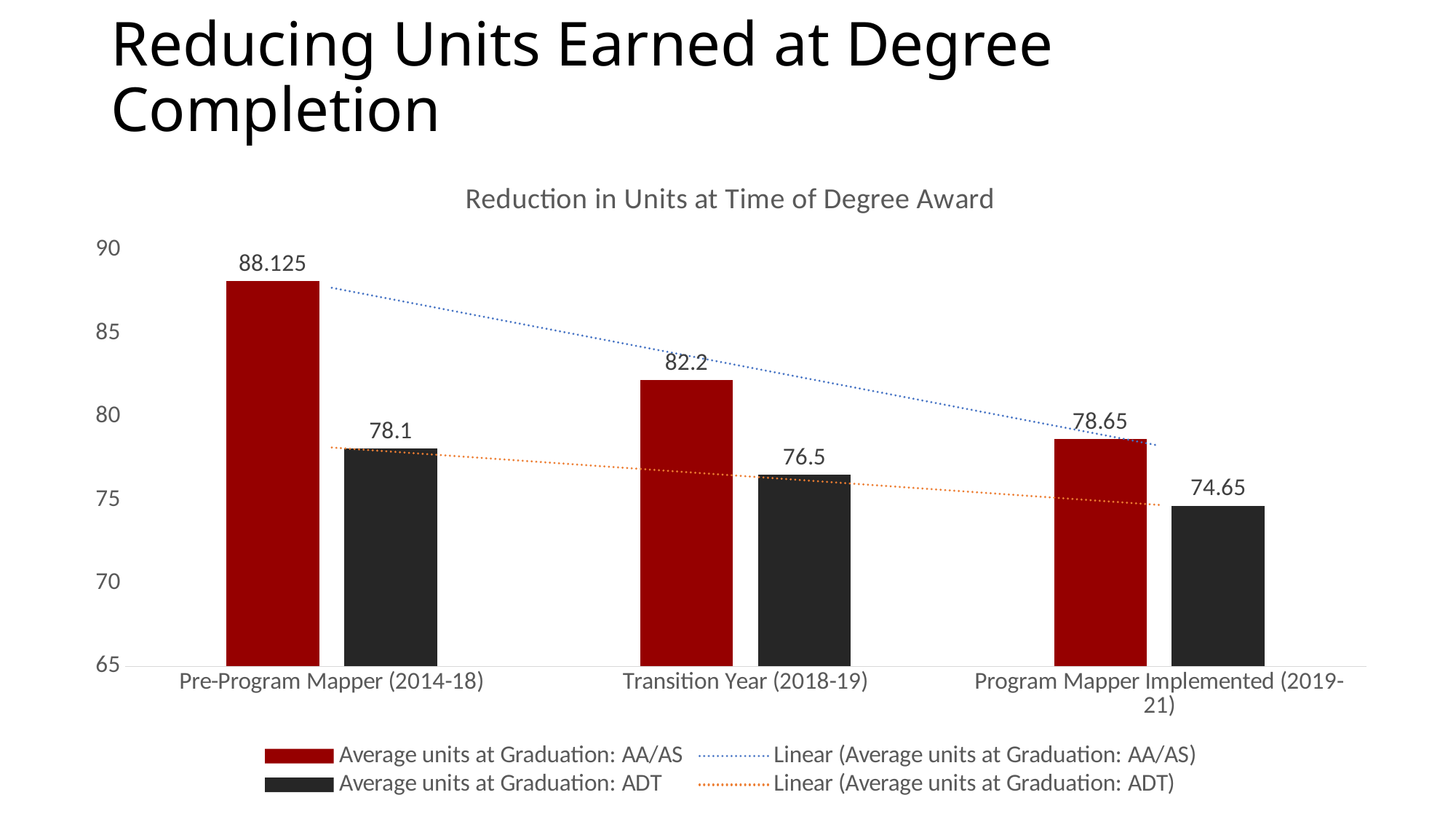
Which period has the highest average units at graduation for AA/AS? Pre-Program Mapper (2014-18) How many periods are shown on the x axis? 3 Which period has the lowest average units at graduation for ADT? Program Mapper Implemented (2019-21) By how much did the AA/AS average units fall from Pre-Program Mapper (2014-18) to Program Mapper Implemented (2019-21)? 9.475 What is the average units at graduation for ADT in the Program Mapper Implemented (2019-21) period? 74.65 What is the average units at graduation for AA/AS in the Pre-Program Mapper (2014-18) period? 88.125 What is the difference between the AA/AS and ADT average units in the Transition Year (2018-19)? 5.7 What is the title of the chart? Reduction in Units at Time of Degree Award Which is larger: the ADT average units in Pre-Program Mapper (2014-18) or the AA/AS average units in Program Mapper Implemented (2019-21)? AA/AS in Program Mapper Implemented (2019-21) What is the average units at graduation for ADT in the Transition Year (2018-19)? 76.5 Do the AA/AS average units rise or fall across the periods from left to right? Fall What is the average units at graduation for AA/AS in the Program Mapper Implemented (2019-21) period? 78.65